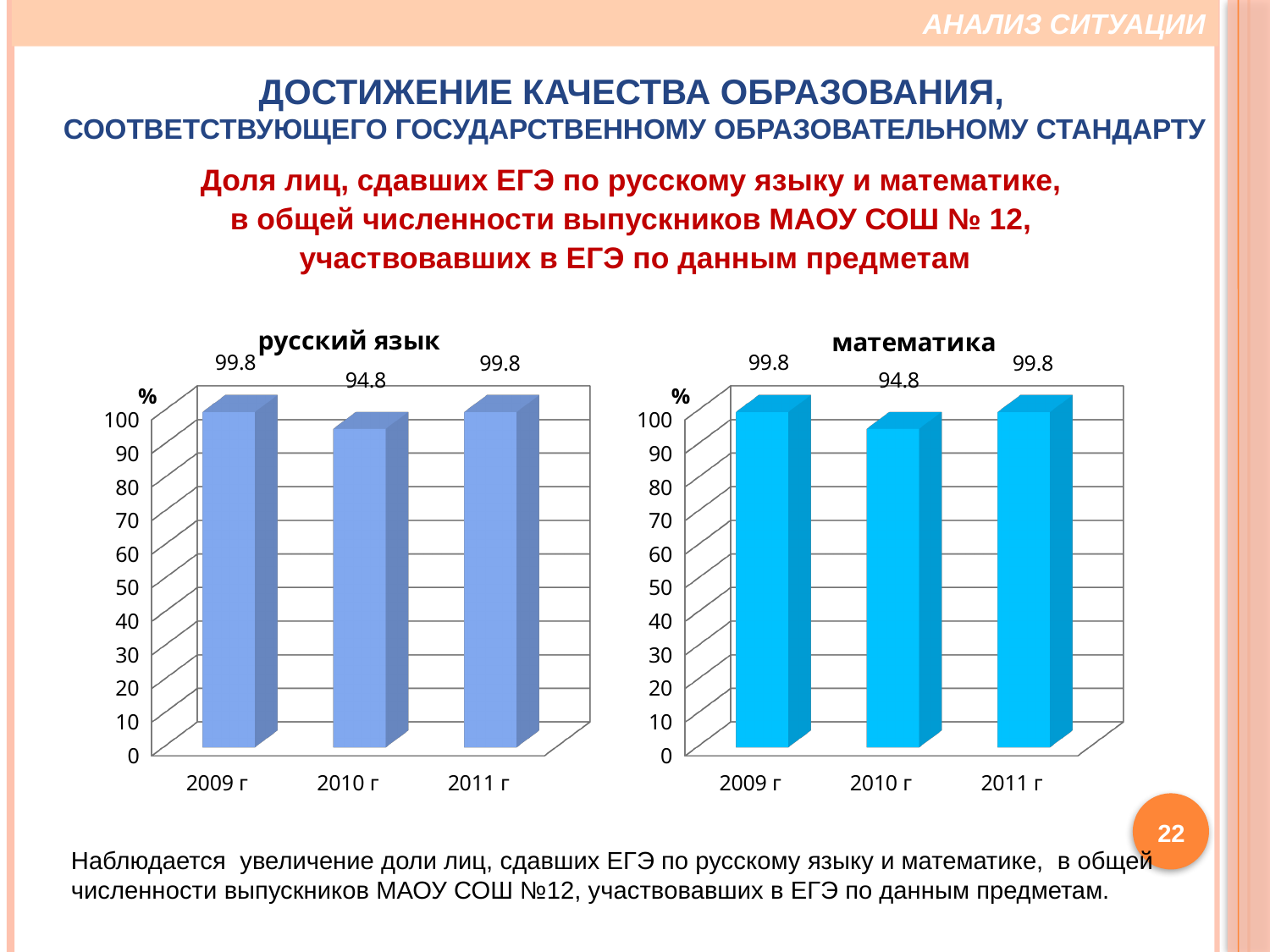
In the 'русский язык' chart, is the value for 2010 г greater or less than 90? greater In the 'математика' chart, do the values rise or fall from 2010 г to 2011 г? rise What is the title of the chart on the right side of the slide? математика How many categories (years) are shown in the 'математика' chart? 3 What kind of chart is the 'русский язык' chart? bar chart In the 'русский язык' chart, what is the value for 2010 г? 94.8 In the 'математика' chart, what is the value for 2011 г? 99.8 In the 'математика' chart, which year has the lowest value? 2010 г What colour are the bars in the 'математика' chart? light blue In the 'русский язык' chart, what is the difference between the values for 2009 г and 2010 г? 5 In the 'русский язык' chart, what is the value for 2009 г? 99.8 In the 'математика' chart, which is larger, the value for 2010 г or the value for 2011 г? 2011 г